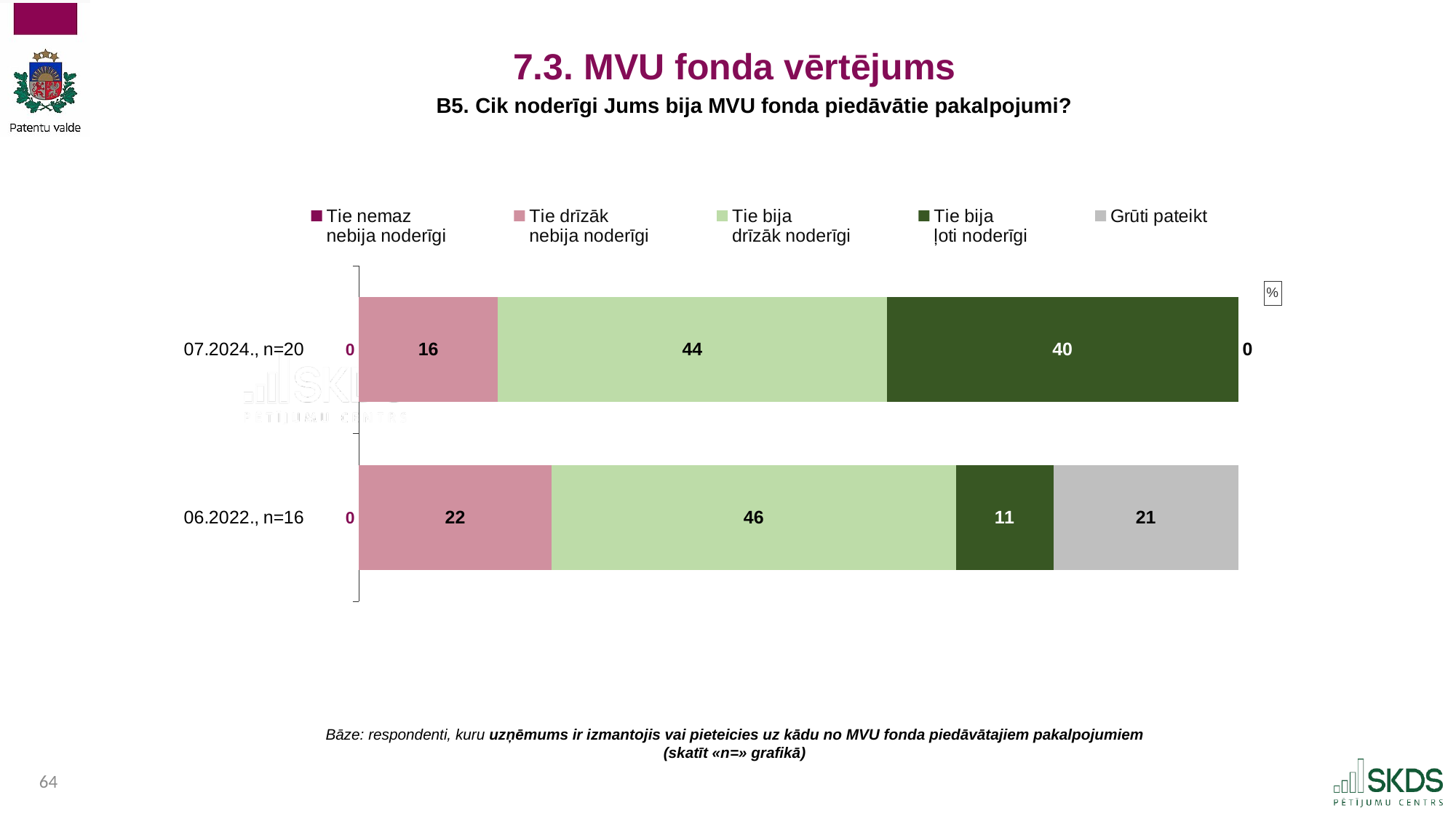
What is the value for "Tie bija drīzāk noderīgi" in the 07.2024., n=20 bar? 44 Which series has the highest value in the 06.2022., n=16 bar? Tie bija drīzāk noderīgi What is the value for "Tie bija ļoti noderīgi" in the 06.2022., n=16 bar? 11 How many series does the legend list? 5 What is the value for "Tie drīzāk nebija noderīgi" in the 07.2024., n=20 bar? 16 How many bars (time periods) are shown in the chart? 2 What is the value for "Grūti pateikt" in the 06.2022., n=16 bar? 21 What is the value for "Tie nemaz nebija noderīgi" in the 07.2024., n=20 bar? 0 What is the total of the 06.2022., n=16 stacked bar? 100 What kind of chart is shown on the slide? Stacked bar chart Which is larger: the "Tie drīzāk nebija noderīgi" value for 07.2024., n=20 or for 06.2022., n=16? 06.2022., n=16 What is the difference between the "Tie bija ļoti noderīgi" values for 07.2024., n=20 and 06.2022., n=16? 29